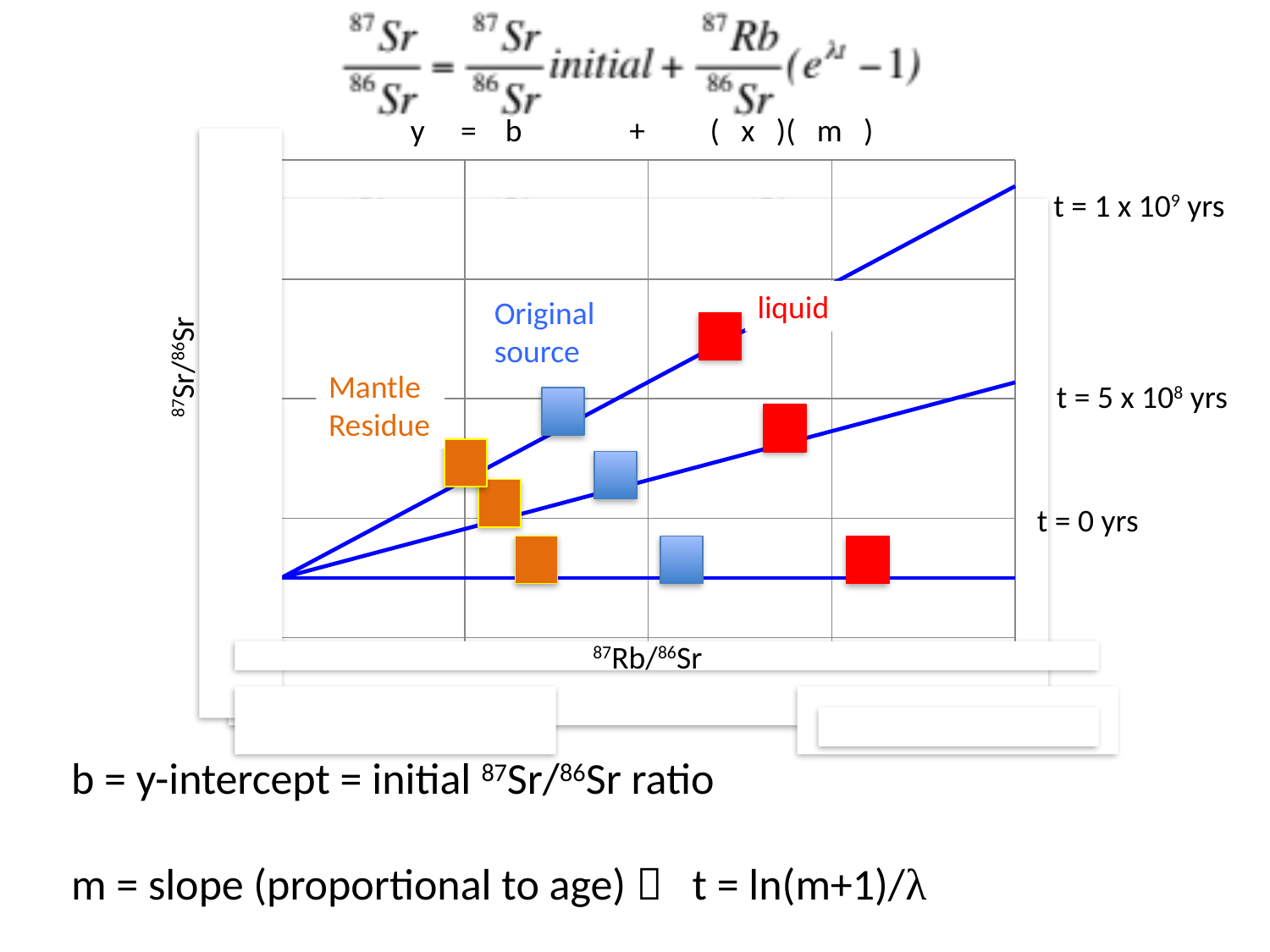
What is the label on the x axis of the chart? 87Rb/86Sr How many sample types (Mantle Residue, Original source, liquid) are labelled on the chart? 3 Along the t = 0 yrs line, which sample has the highest 87Rb/86Sr value? liquid How many blue isochron lines are drawn on the chart? 3 What is the label on the y axis of the chart? 87Sr/86Sr On the t = 1 x 10^9 yrs line, is the 87Sr/86Sr value of the liquid greater or less than that of the Mantle Residue? greater How many coloured square data points are plotted on the chart? 9 Which isochron line has the steepest slope? t = 1 x 10^9 yrs Along the t = 0 yrs line, which sample has the lowest 87Rb/86Sr value? Mantle Residue On the t = 5 x 10^8 yrs line, is the 87Sr/86Sr value of the Original source greater or less than that of the liquid? less Along the t = 5 x 10^8 yrs line, does 87Sr/86Sr rise or fall as 87Rb/86Sr increases? rise Which isochron line is horizontal (has zero slope)? t = 0 yrs